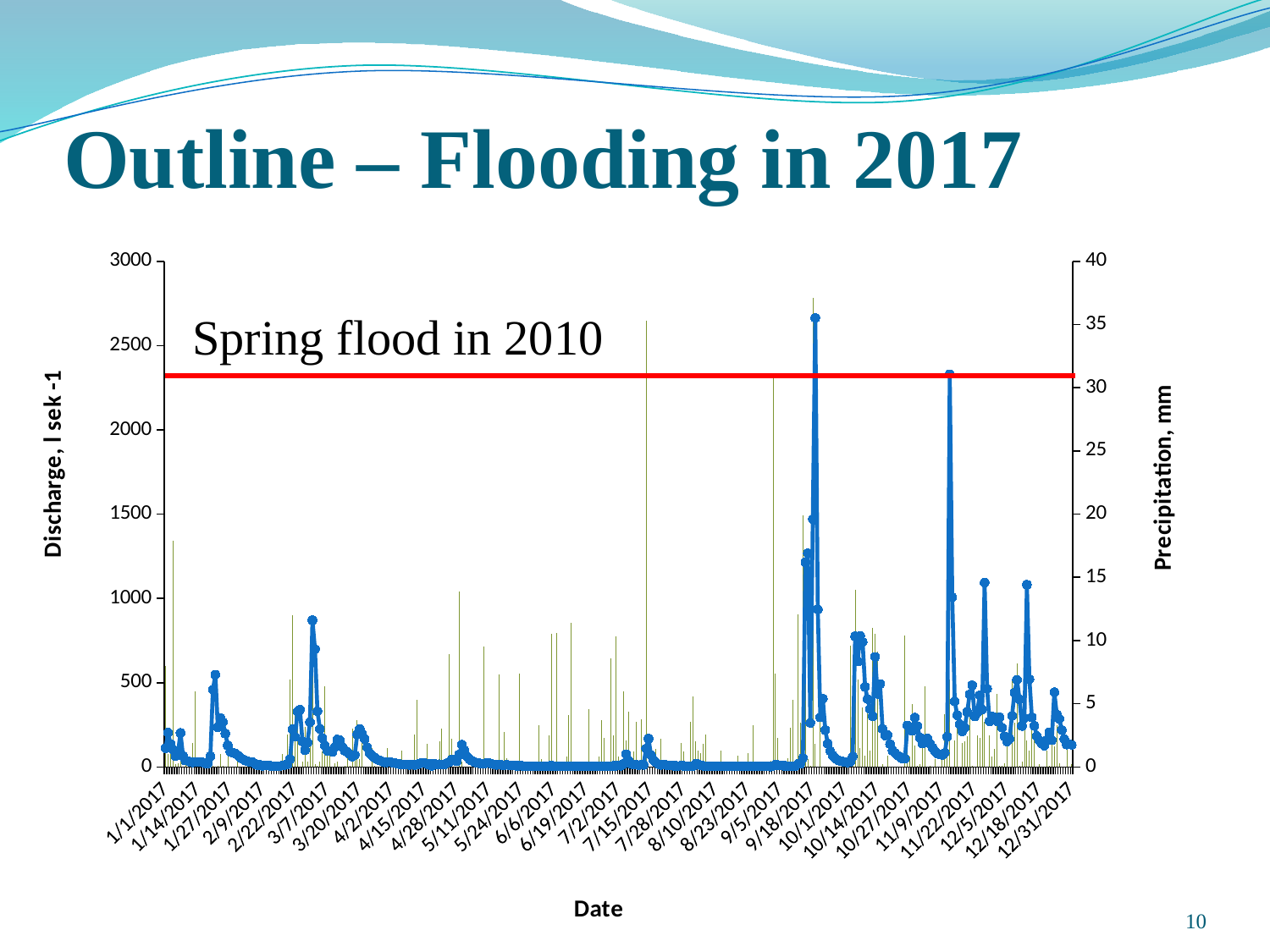
Is the red 'Spring flood in 2010' line greater or less than 2000 on the discharge axis? greater What is the title of the right vertical axis? Precipitation, mm Which discharge peak is larger: the one near 3/7/2017 or the one near 1/27/2017? 3/7/2017 Is the discharge peak near 11/9/2017 greater or less than 2000? greater What is the title of the left vertical axis? Discharge, l sek -1 Is the tallest precipitation bar, near 9/18/2017, greater or less than 30 mm? greater Near which x-axis date label does the highest discharge peak occur? 9/18/2017 Which discharge peak is larger: the one near 9/18/2017 or the one near 11/9/2017? 9/18/2017 What kind of chart is used to plot the discharge series? line chart